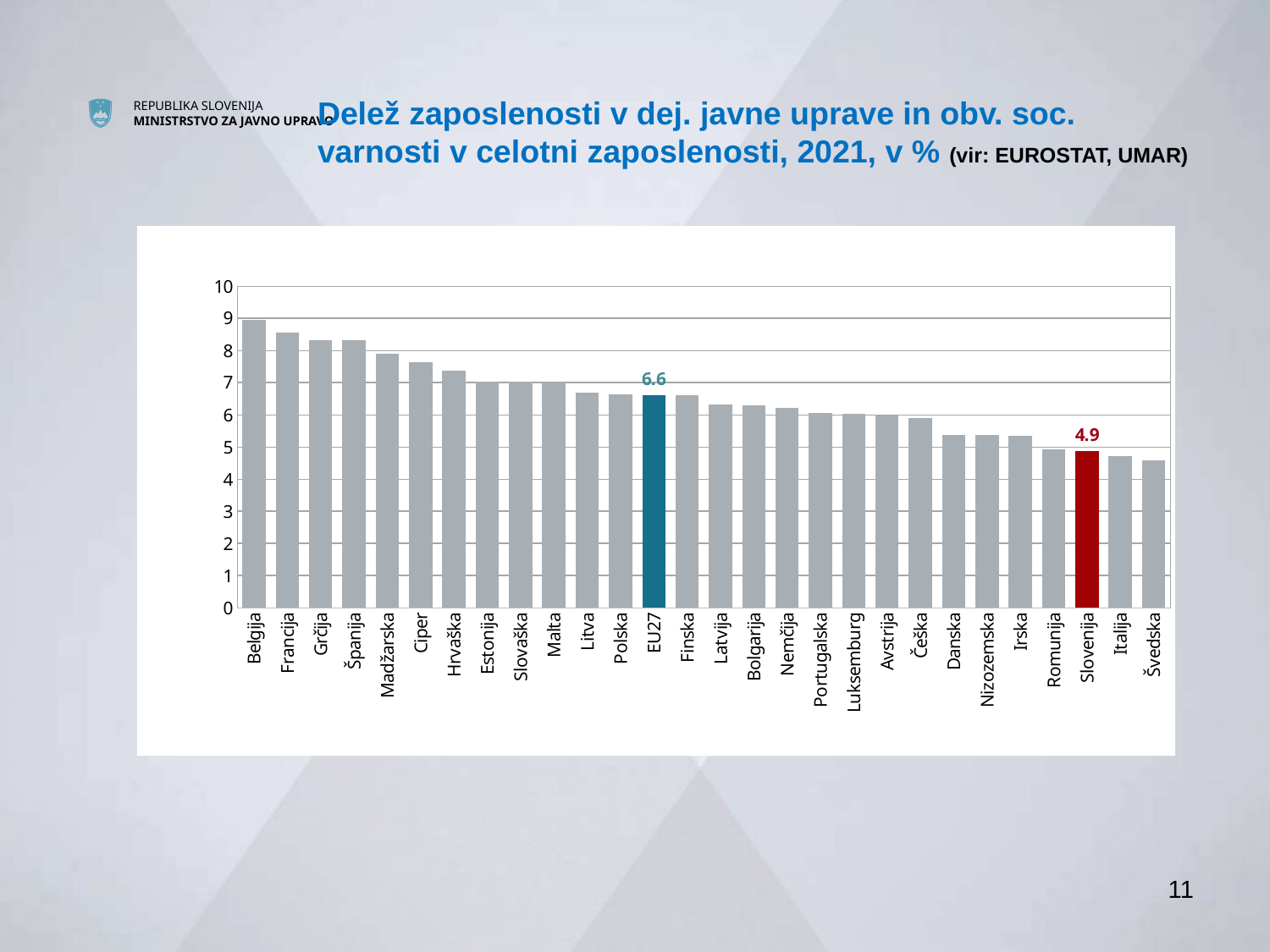
Which has a larger value, Danska or Madžarska? Madžarska Is the value for Italija greater or less than 5? less Do the values rise or fall from left to right along the x axis? Fall What value is shown for EU27? 6.6 What value is shown for Slovenija? 4.9 What kind of chart is shown on the slide? Bar chart Which has a larger value, Francija or Slovenija? Francija Which country has the highest value in the chart? Belgija Is the value for Nemčija greater or less than 6? greater Is the value for Madžarska greater or less than 7? greater How many bars are shown in the chart? 28 What is the difference between the EU27 value and the Slovenija value? 1.7